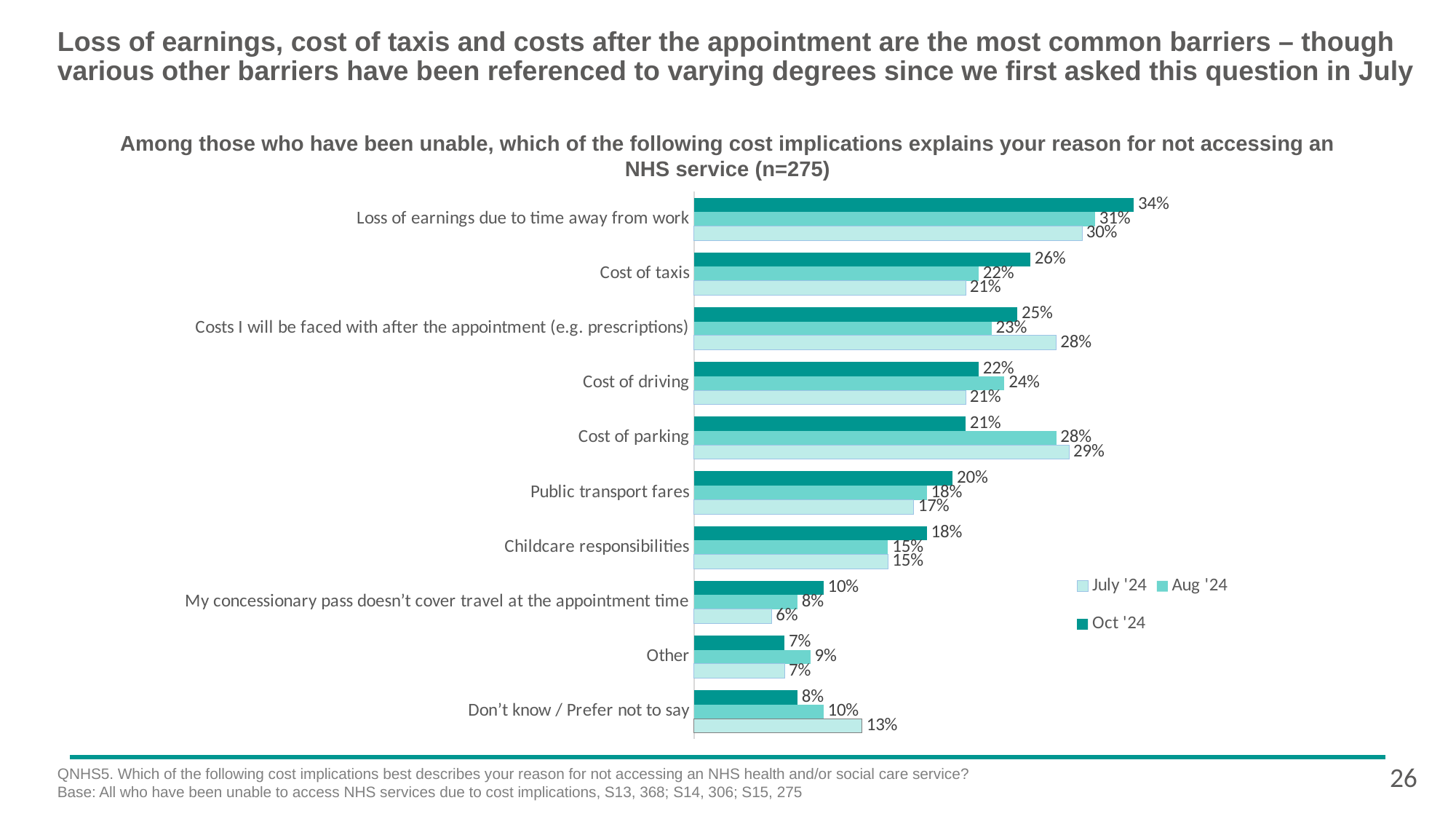
For Cost of parking, which is larger: the Oct '24 value or the July '24 value? July '24 What kind of chart is shown on the slide? Bar chart What is the Oct '24 value for Loss of earnings due to time away from work? 34% What is the July '24 value for My concessionary pass doesn't cover travel at the appointment time? 6% What is the sample size (n) stated in the chart title? 275 How many series does the legend list? 3 Which category has the highest Oct '24 value? Loss of earnings due to time away from work What is the July '24 value for Cost of parking? 29% What is the difference between the Oct '24 and July '24 values for Cost of taxis? 5 percentage points What is the Aug '24 value for Cost of driving? 24% Which category has the lowest July '24 value? My concessionary pass doesn't cover travel at the appointment time How many categories are shown on the chart? 10